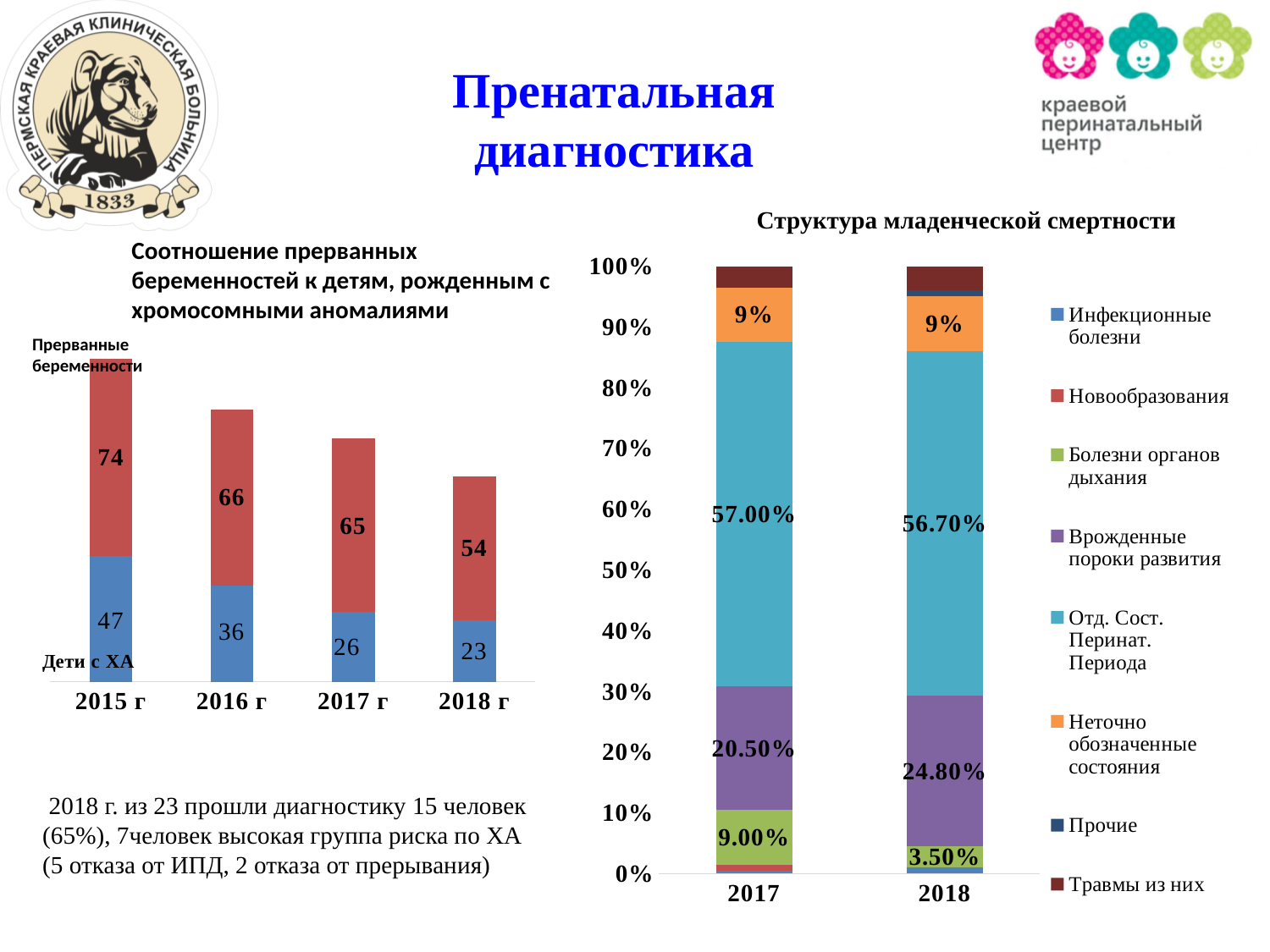
In the left chart on abortions and children with chromosomal anomalies, which year has the highest value for Дети с ХА? 2015 г In the left chart on abortions and children with chromosomal anomalies, do the values for Дети с ХА rise or fall from 2015 г to 2018 г? fall In the left chart on abortions and children with chromosomal anomalies, which year has the lowest value for Прерванные беременности? 2018 г In the chart 'Структура младенческой смертности', how many series does the legend list? 8 In the left chart on abortions and children with chromosomal anomalies, what is the value for Прерванные беременности in 2015 г? 74 In the left chart on abortions and children with chromosomal anomalies, what is the value for Дети с ХА in 2018 г? 23 In the left chart on abortions and children with chromosomal anomalies, what is the total of the stacked bar for 2017 г? 91 In the chart 'Структура младенческой смертности', what is the value for Болезни органов дыхания in 2018? 3.50% In the chart 'Структура младенческой смертности', which year has the larger value for Врожденные пороки развития, 2017 or 2018? 2018 In the left chart on abortions and children with chromosomal anomalies, how many years are shown on the x axis? 4 In the left chart on abortions and children with chromosomal anomalies, what is the difference between Прерванные беременности and Дети с ХА in 2016 г? 30 In the chart 'Структура младенческой смертности', what is the value for Отд. Сост. Перинат. Периода in 2017? 57.00%